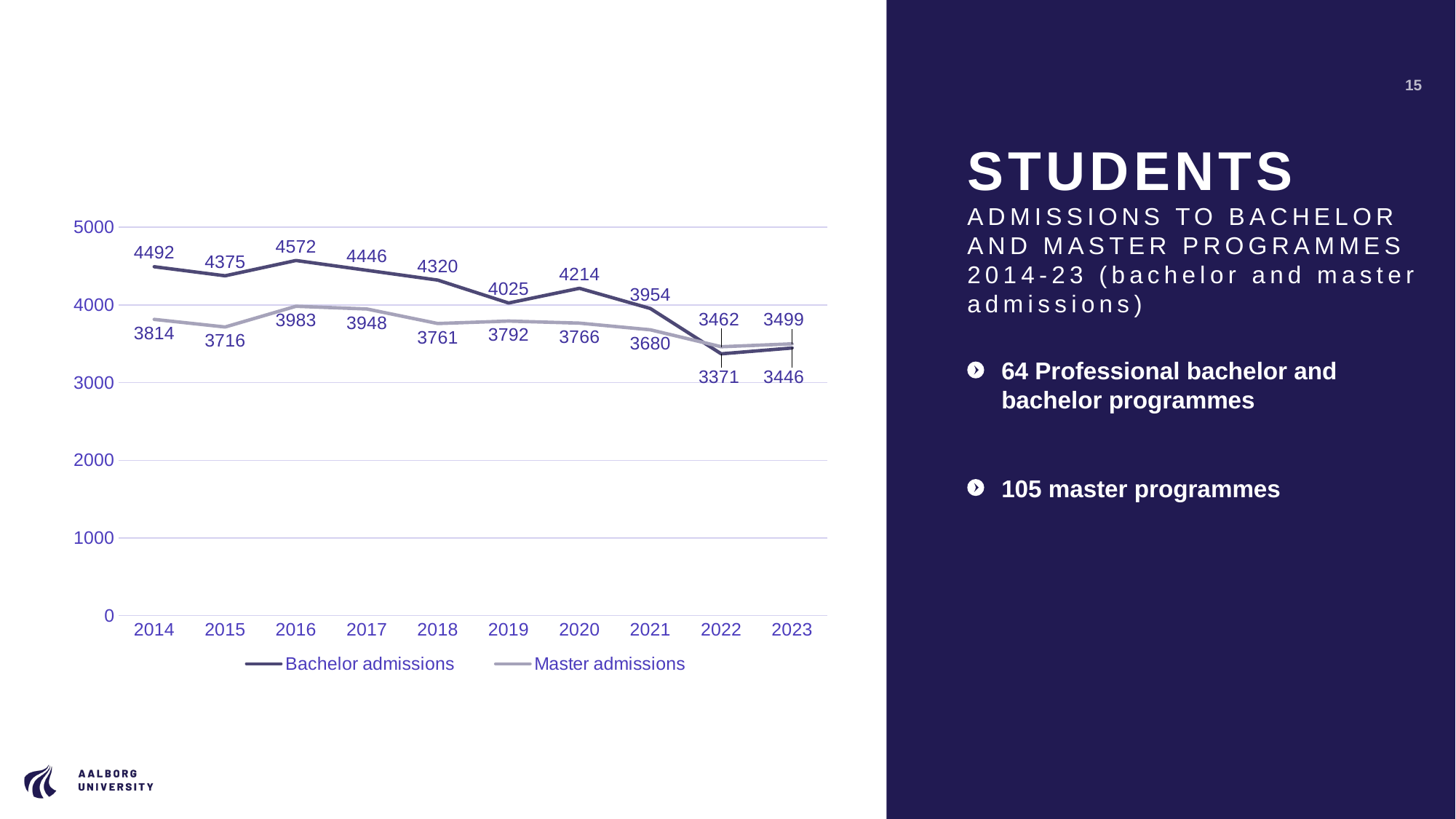
What was the number of Master admissions in 2021? 3680 In which year were Master admissions lowest? 2022 Is the value for Master admissions in 2016 greater or less than 4000? less In which year were Bachelor admissions highest? 2016 Do Bachelor admissions generally rise or fall from 2014 to 2023? Fall What type of chart is shown on the slide? Line chart How many series does the legend list? 2 What was the number of Bachelor admissions in 2016? 4572 How many years are shown on the x axis? 10 In which year were Bachelor admissions lowest? 2022 Which was larger in 2023, Bachelor admissions or Master admissions? Master admissions What is the difference between Bachelor admissions and Master admissions in 2014? 678